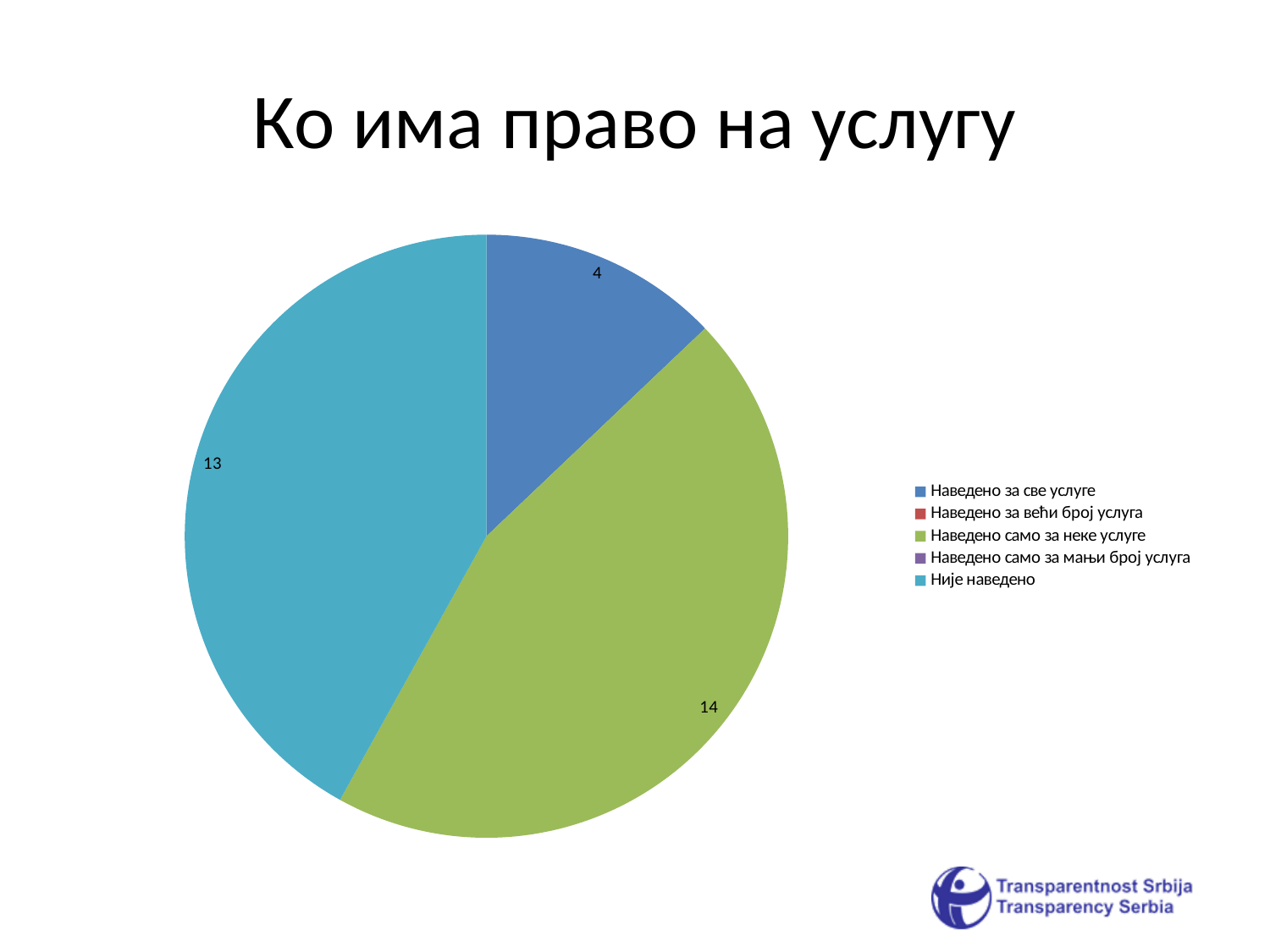
What is the value for the slice 'Наведено само за неке услуге'? 14 What is the value for the slice 'Наведено за све услуге'? 4 Which of the labelled slices has the smallest value? Наведено за све услуге What is the difference between the values for 'Није наведено' and 'Наведено за све услуге'? 9 Which is larger: the value for 'Наведено само за неке услуге' or the value for 'Наведено за све услуге'? Наведено само за неке услуге What type of chart is shown on the slide? pie chart Which category has the largest slice in the pie chart? Наведено само за неке услуге How many entries does the legend list? 5 How many slices with data labels are visible in the pie chart? 3 What is the difference between the values for 'Наведено само за неке услуге' and 'Није наведено'? 1 What is the value for the slice 'Није наведено'? 13 What is the title of the chart? Ко има право на услугу